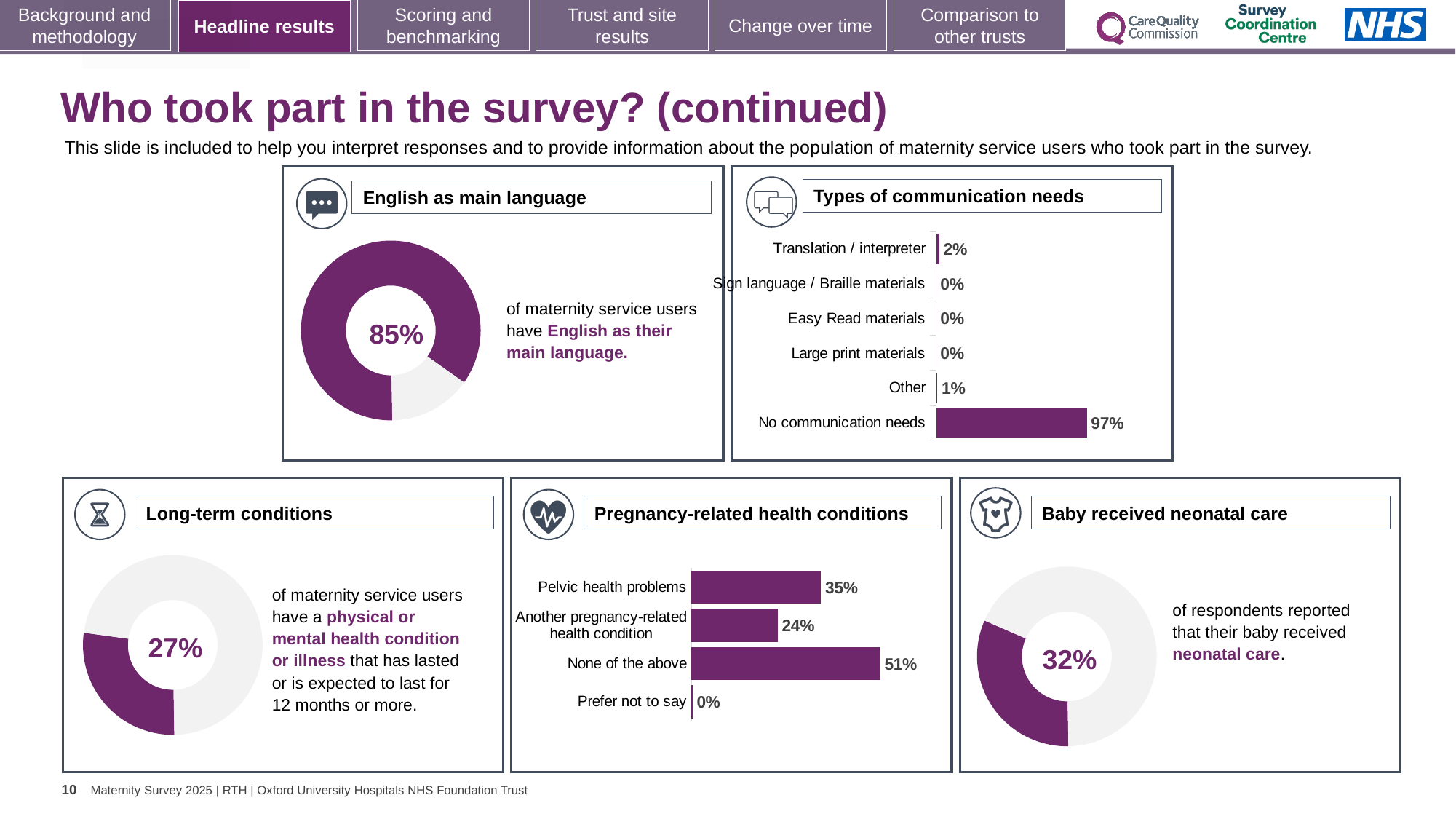
In the 'Pregnancy-related health conditions' chart, which category has the highest value? None of the above In the 'Pregnancy-related health conditions' chart, which is larger: Pelvic health problems or Another pregnancy-related health condition? Pelvic health problems What kind of chart is used in the 'Pregnancy-related health conditions' panel? Bar chart In the 'Types of communication needs' chart, what is the value for Translation / interpreter? 2% In the 'Pregnancy-related health conditions' chart, what is the difference between 'None of the above' and 'Another pregnancy-related health condition'? 27% In the 'Long-term conditions' chart, what percentage of maternity service users have a physical or mental health condition or illness lasting 12 months or more? 27% In the 'Types of communication needs' chart, what percentage of maternity service users reported no communication needs? 97% In the 'Pregnancy-related health conditions' chart, what is the value for Pelvic health problems? 35% In the 'Types of communication needs' chart, which category has the highest value? No communication needs How many categories are shown in the 'Types of communication needs' chart? 6 In the 'Baby received neonatal care' chart, what percentage of respondents reported that their baby received neonatal care? 32% In the 'English as main language' chart, what percentage of maternity service users have English as their main language? 85%